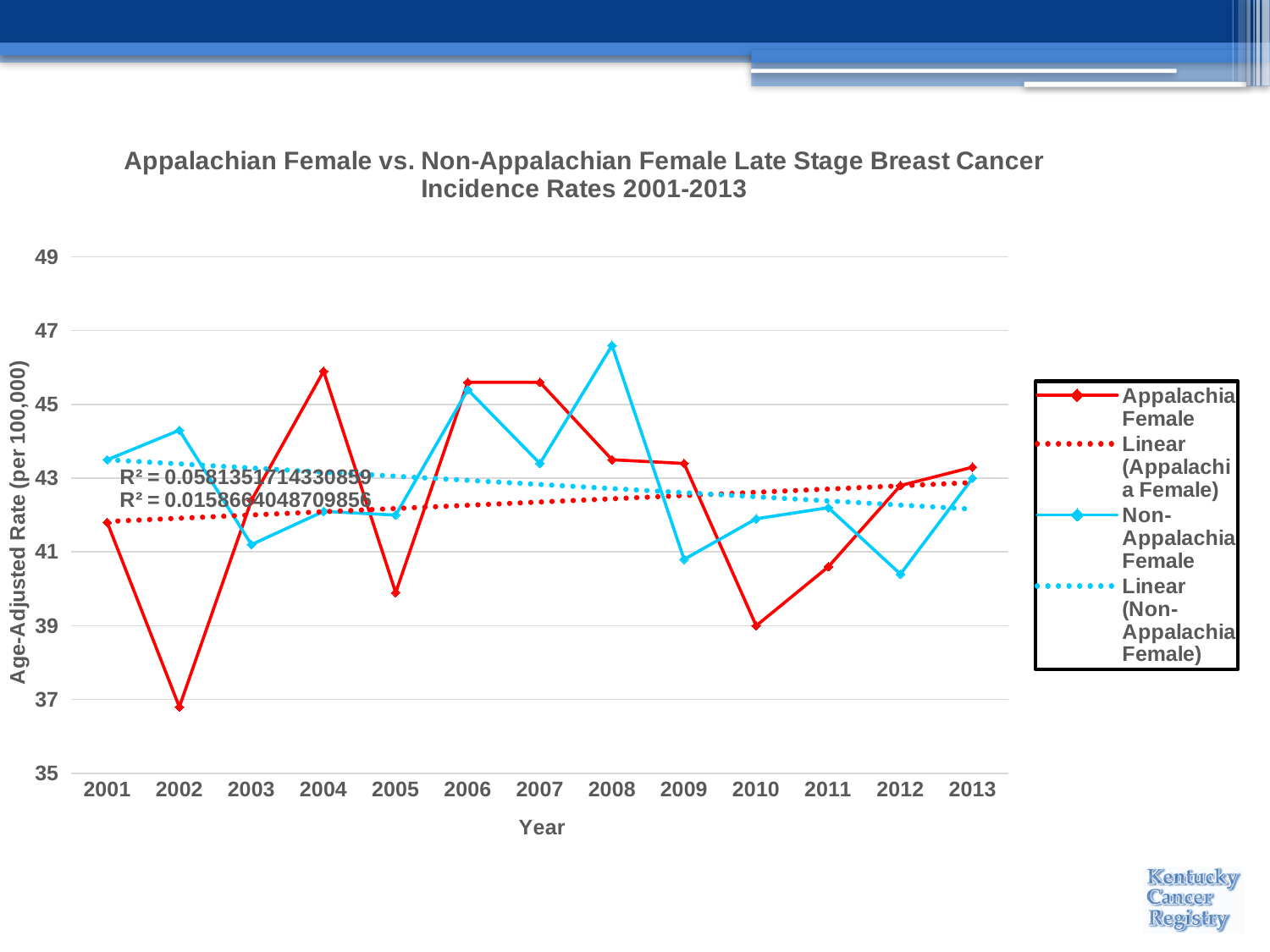
What kind of chart is shown on the slide? line chart Is the Non-Appalachian Female value for 2008 greater or less than 45? greater Is the Appalachian Female value for 2005 greater or less than 41? less In which year is the Appalachian Female rate lowest? 2002 Is the Appalachian Female value for 2004 greater or less than 45? greater What is the title of the chart? Appalachian Female vs. Non-Appalachian Female Late Stage Breast Cancer Incidence Rates 2001-2013 How many entries does the chart legend list? 4 In which year is the Non-Appalachian Female rate highest? 2008 How many years are plotted along the x axis? 13 In 2004, which series has the larger value, Appalachian Female or Non-Appalachian Female? Appalachian Female In 2002, which series has the larger value, Appalachian Female or Non-Appalachian Female? Non-Appalachian Female